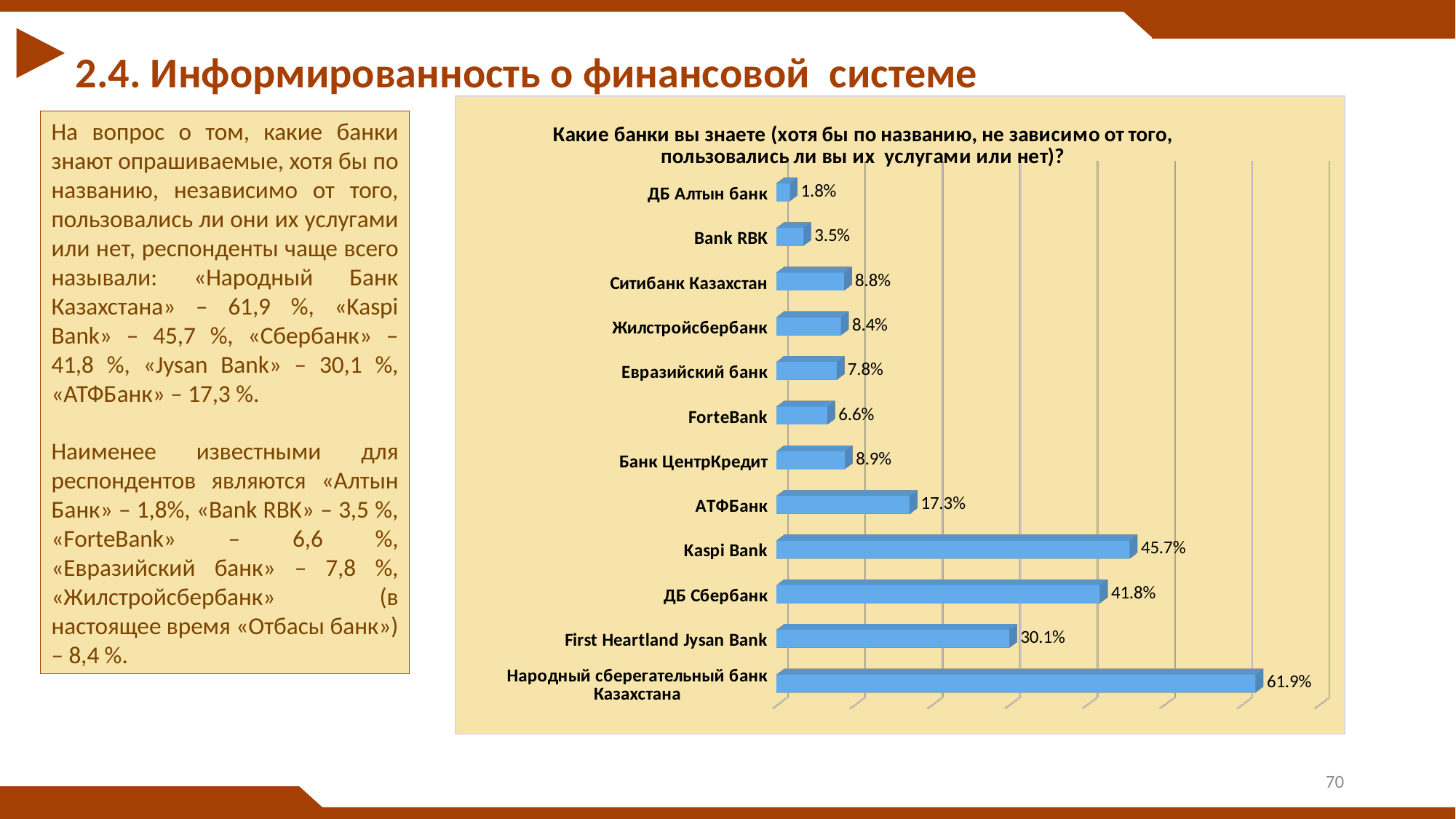
Which bank has the highest value in the chart? Народный сберегательный банк Казахстана What is the difference between the values for Kaspi Bank and ДБ Сбербанк? 3.9% What is the value for First Heartland Jysan Bank? 30.1% How many banks are listed in the chart? 12 Which is larger, the value for Жилстройсбербанк or the value for Евразийский банк? Жилстройсбербанк Which bank has the lowest value in the chart? ДБ Алтын банк What is the value for Kaspi Bank? 45.7% What is the title of the chart? Какие банки вы знаете (хотя бы по названию, не зависимо от того, пользовались ли вы их услугами или нет)? What kind of chart is shown on the slide? Bar chart What is the value for ForteBank? 6.6% What is the value for Банк ЦентрКредит? 8.9% What is the difference between the values for АТФБанк and Ситибанк Казахстан? 8.5%